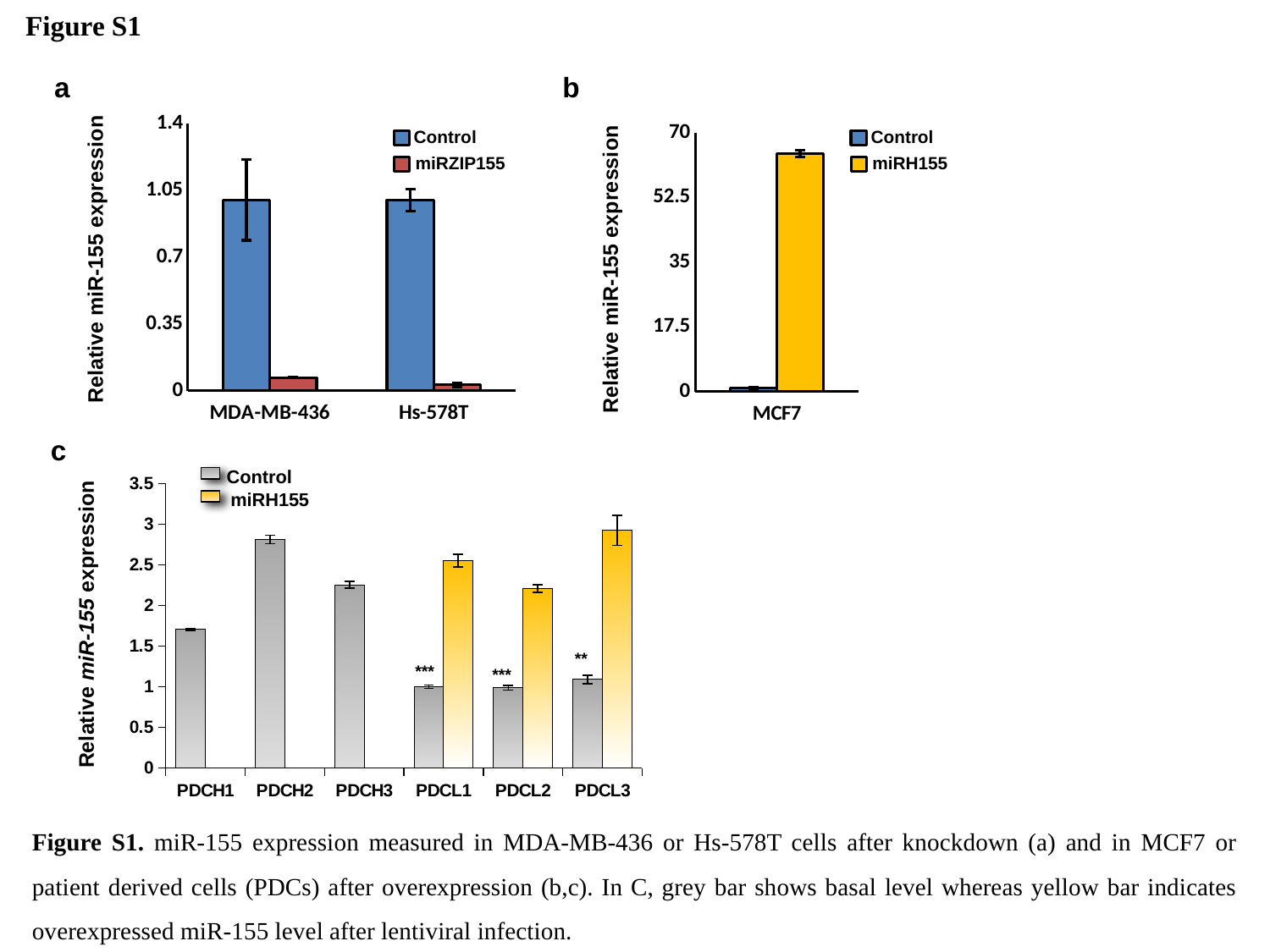
In chart c, which category has the lowest miRH155 bar? PDCL2 What kind of chart is chart c (bottom left)? bar chart In chart b, is the miRH155 value for MCF7 greater or less than 52.5? greater In chart c, for PDCL1, which is larger: the Control bar or the miRH155 bar? miRH155 How many series does the legend of chart a list? 2 How many categories are shown on the x axis of chart c? 6 In chart b, what are the two legend entries? Control and miRH155 In chart a, is the miRZIP155 value for Hs-578T greater or less than 0.35? less In chart b, is the Control value for MCF7 greater or less than 17.5? less In chart c, which category has the highest Control bar? PDCH2